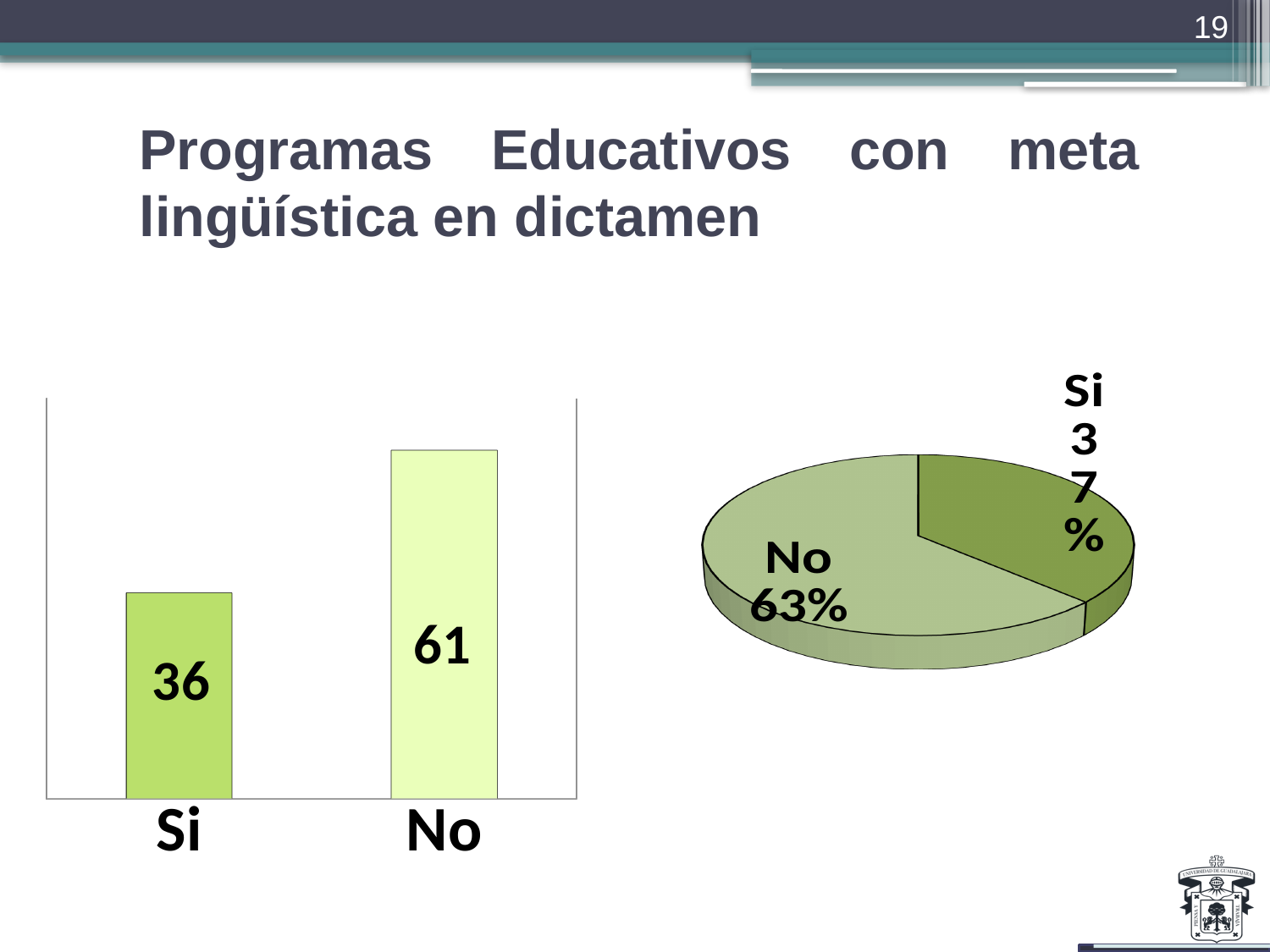
In the bar chart on the left, how many categories are shown? 2 In the pie chart on the right, what share does the No slice have? 63% In the bar chart on the left, what is the value for No? 61 In the pie chart on the right, which slice is larger, Si or No? No In the pie chart on the right, what share does the Si slice have? 37% In the bar chart on the left, what is the value for Si? 36 What kind of chart is the chart on the right? pie chart In the bar chart on the left, which is larger, the value for Si or the value for No? No In the bar chart on the left, which category has the lowest value? Si What kind of chart is the chart on the left? bar chart In the bar chart on the left, what is the difference between the values for No and Si? 25 In the bar chart on the left, which category has the highest value? No